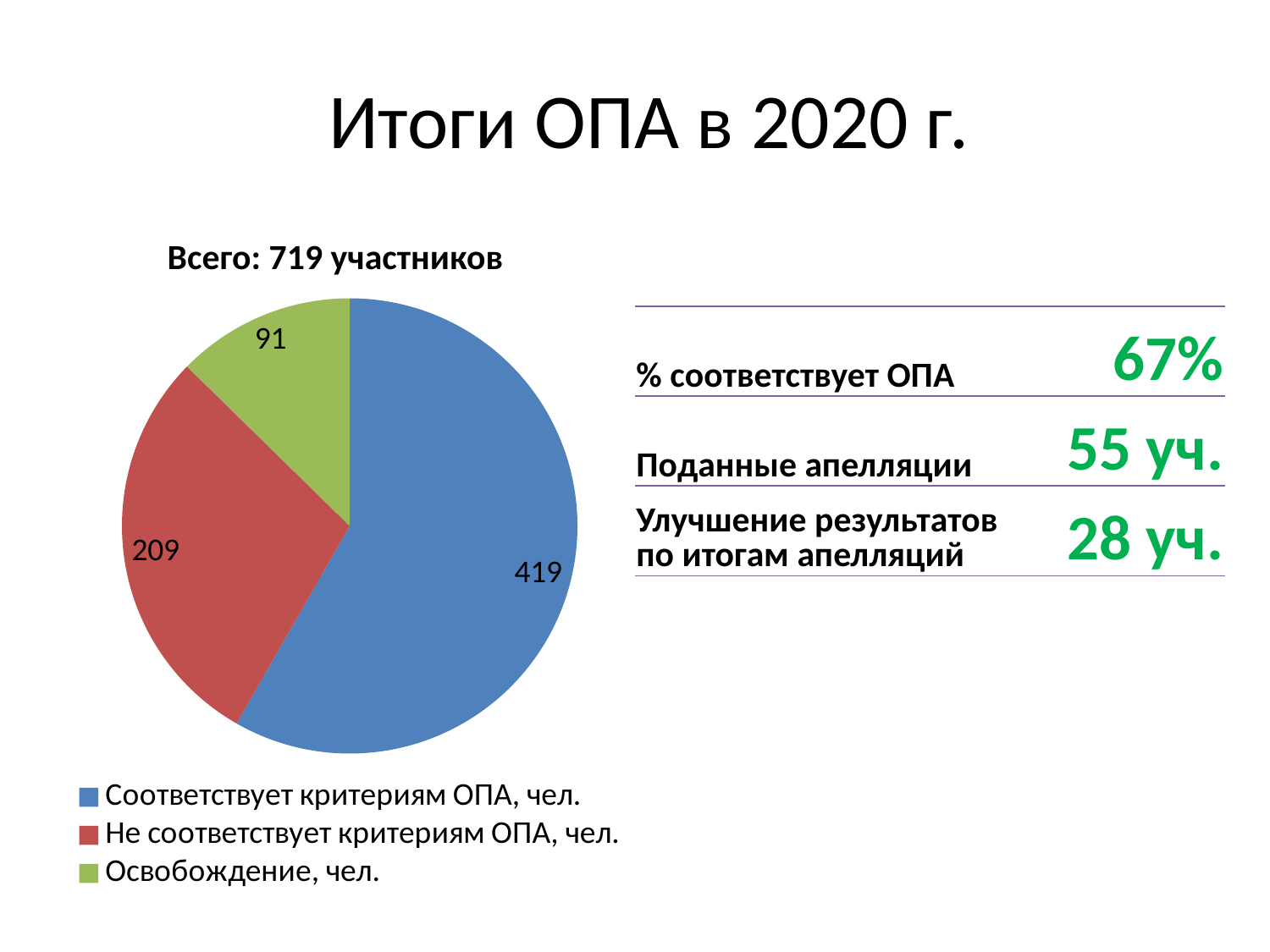
Which is larger: the value for "Не соответствует критериям ОПА, чел." or the value for "Освобождение, чел."? Не соответствует критериям ОПА, чел. What is the value for "Соответствует критериям ОПА, чел." in the pie chart? 419 What is the title of the pie chart? Всего: 719 участников What is the value for "Не соответствует критериям ОПА, чел." in the pie chart? 209 What is the difference between the values for "Соответствует критериям ОПА, чел." and "Не соответствует критериям ОПА, чел."? 210 How many slices does the pie chart have? 3 What colour is the slice for "Освобождение, чел." in the pie chart? green What type of chart is shown on the slide? pie chart What is the value for "Освобождение, чел." in the pie chart? 91 Which category has the largest slice in the pie chart? Соответствует критериям ОПА, чел. How many entries does the legend of the pie chart list? 3 Which category has the smallest slice in the pie chart? Освобождение, чел.